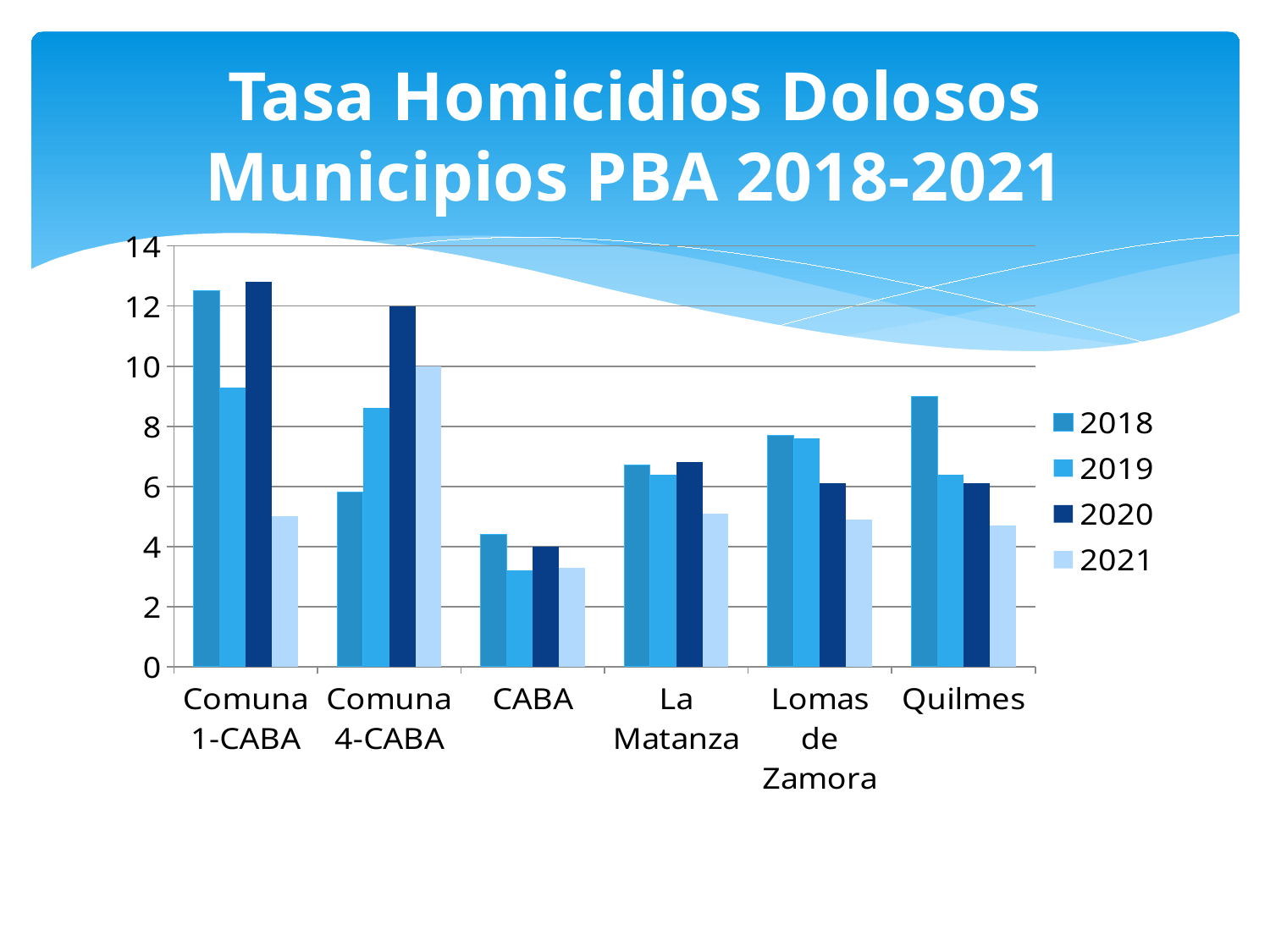
How many municipalities (categories) are shown on the x axis? 6 Is the 2019 value for CABA greater or less than 4? less Is the 2018 value for Quilmes greater or less than 8? greater For Comuna 4-CABA, which is larger: the 2018 value or the 2020 value? 2020 What kind of chart is shown on the slide? bar chart How many series does the legend list? 4 For Quilmes, do the values rise or fall from 2018 to 2021? fall Which category has the lowest 2021 value? CABA Is the 2021 value for Lomas de Zamora greater or less than 6? less Which category has the highest 2018 value? Comuna 1-CABA What are the entries listed in the legend? 2018, 2019, 2020, 2021